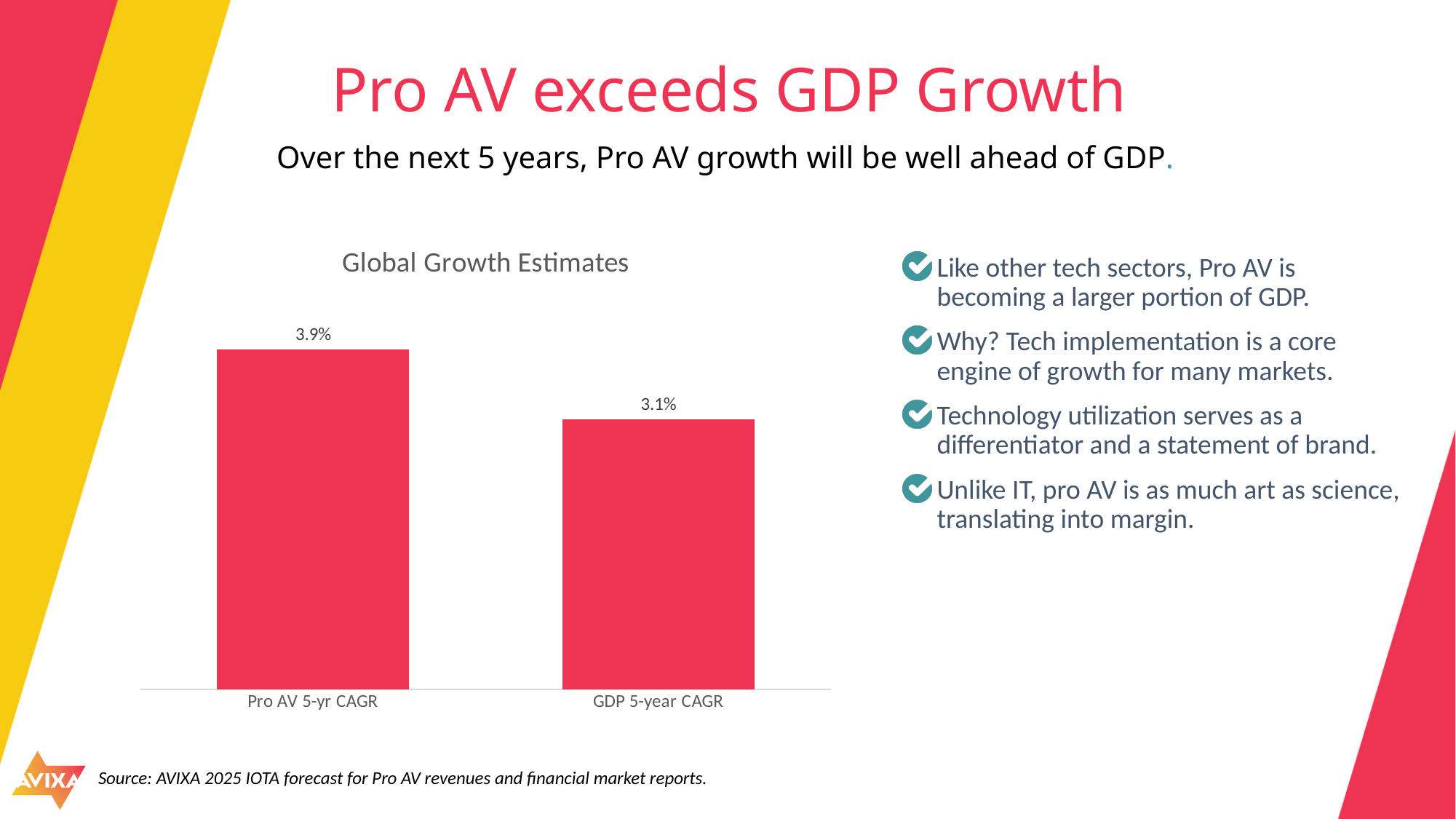
What is the value for GDP 5-year CAGR? 3.1% What is the title of the chart? Global Growth Estimates What is the value for Pro AV 5-yr CAGR? 3.9% Which category has the lowest value? GDP 5-year CAGR How many categories are shown in the chart? 2 What kind of chart is shown on the slide? Bar chart What is the difference between the Pro AV 5-yr CAGR and the GDP 5-year CAGR? 0.8% What colour are the bars in the chart? Red Which category has the highest value? Pro AV 5-yr CAGR Which is larger, Pro AV 5-yr CAGR or GDP 5-year CAGR? Pro AV 5-yr CAGR